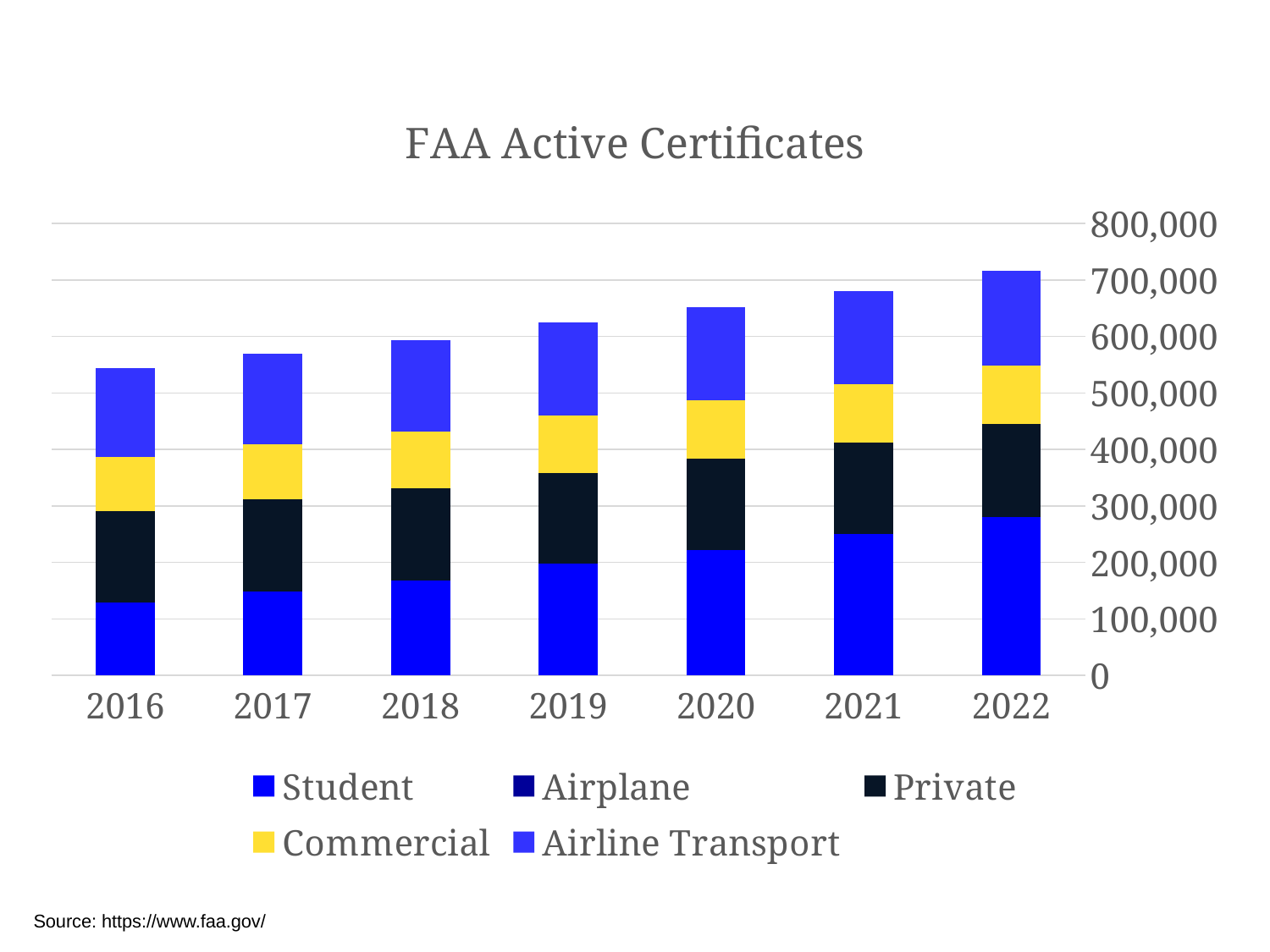
Do the total active certificates rise or fall from 2016 to 2022? Rise What is the title of the chart? FAA Active Certificates Is the Student value for 2022 greater or less than 200,000? greater Is the total for 2016 greater or less than 600,000? less Which year has the lowest total of active certificates? 2016 What type of chart is shown on the slide? Stacked bar chart How many years are shown on the x axis? 7 Which year has the larger total, 2018 or 2020? 2020 Which series is shown in yellow in the legend? Commercial Which year has the highest total of active certificates? 2022 How many series does the legend list? 5 Is the total for 2022 greater or less than 700,000? greater